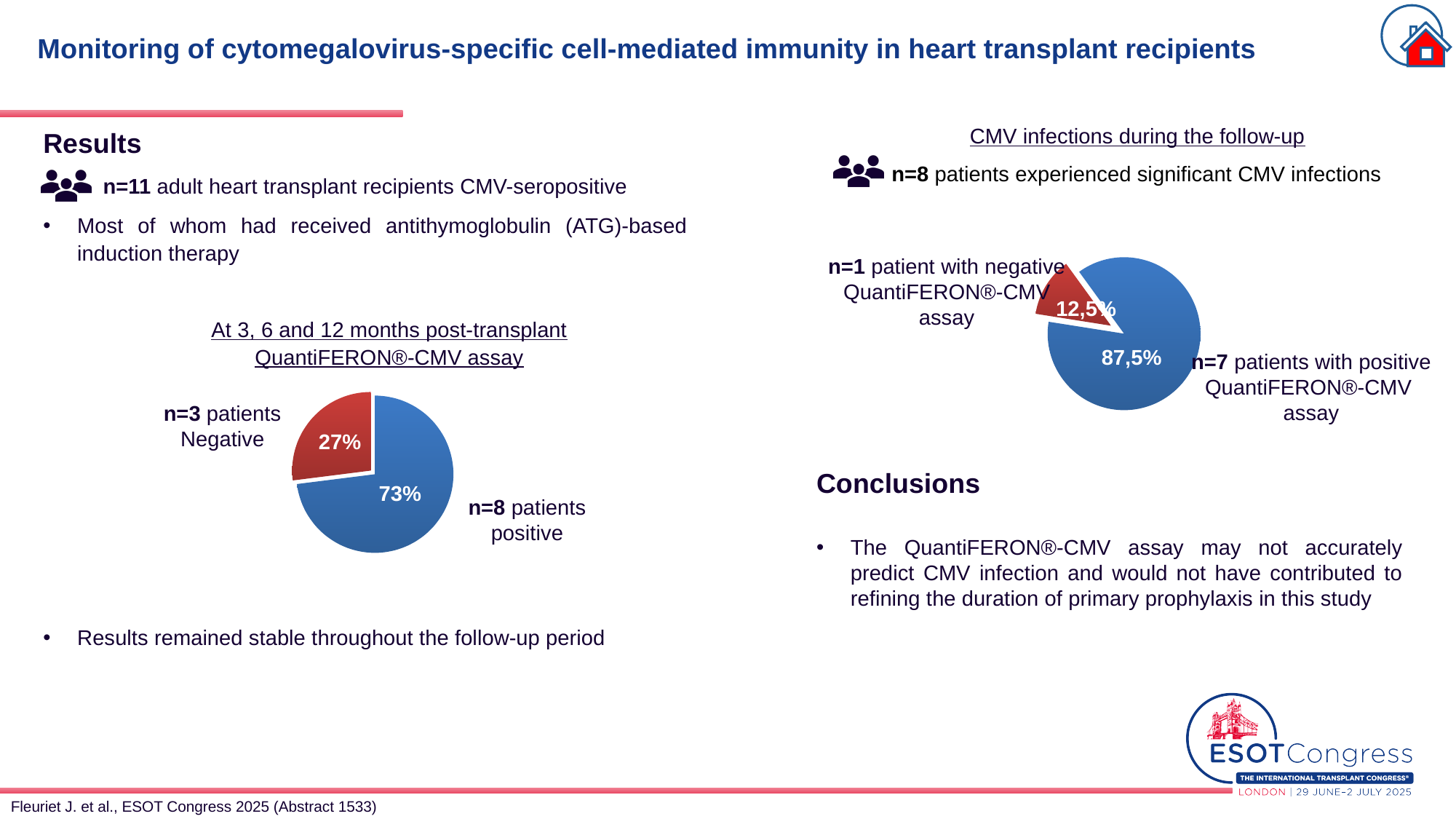
In the right pie chart (CMV infections during the follow-up), what share of patients had a negative QuantiFERON®-CMV assay? 12,5% In the left pie chart (QuantiFERON®-CMV assay at 3, 6 and 12 months), what share of patients were negative? 27% In the left pie chart (QuantiFERON®-CMV assay at 3, 6 and 12 months), which slice is larger, positive or negative? Positive In the right pie chart (CMV infections during the follow-up), how many patients had a negative QuantiFERON®-CMV assay? n=1 In the left pie chart (QuantiFERON®-CMV assay at 3, 6 and 12 months), how many patients were positive? n=8 In the right pie chart (CMV infections during the follow-up), what is the difference in percentage points between the positive and negative slices? 75 percentage points In the right pie chart (CMV infections during the follow-up), what colour is the slice for patients with a negative QuantiFERON®-CMV assay? Red In the left pie chart (QuantiFERON®-CMV assay at 3, 6 and 12 months), how many patients were negative? n=3 How many slices does the left pie chart (QuantiFERON®-CMV assay at 3, 6 and 12 months) have? 2 In the left pie chart (QuantiFERON®-CMV assay at 3, 6 and 12 months), what share of patients were positive? 73% What kind of chart is the left chart titled 'At 3, 6 and 12 months post-transplant QuantiFERON®-CMV assay'? Pie chart